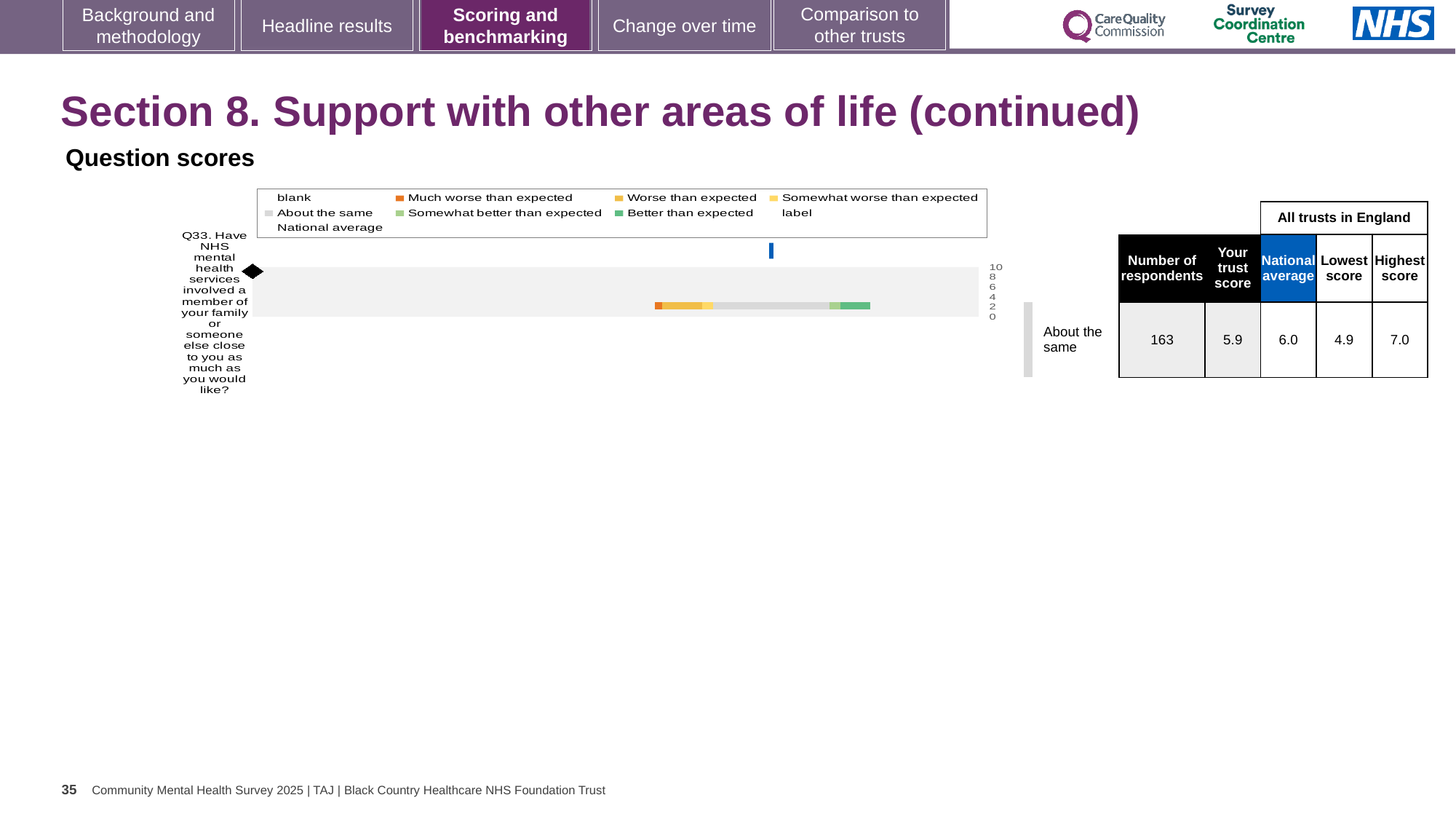
What is the trust's score for Q33 shown on the slide? 5.9 What kind of chart is shown on the slide? Bar chart How is the trust's Q33 score categorised relative to other trusts? About the same What is the lowest score among all trusts in England for Q33? 4.9 What is the national average score for Q33 shown on the slide? 6.0 How many questions are plotted in the chart? 1 How many respondents answered Q33? 163 Which is larger for Q33: the trust's score or the national average? National average What is the highest score among all trusts in England for Q33? 7.0 What is the heading above the chart? Question scores What is the maximum value shown on the chart's axis? 10 What is the difference between the highest and lowest trust scores for Q33? 2.1